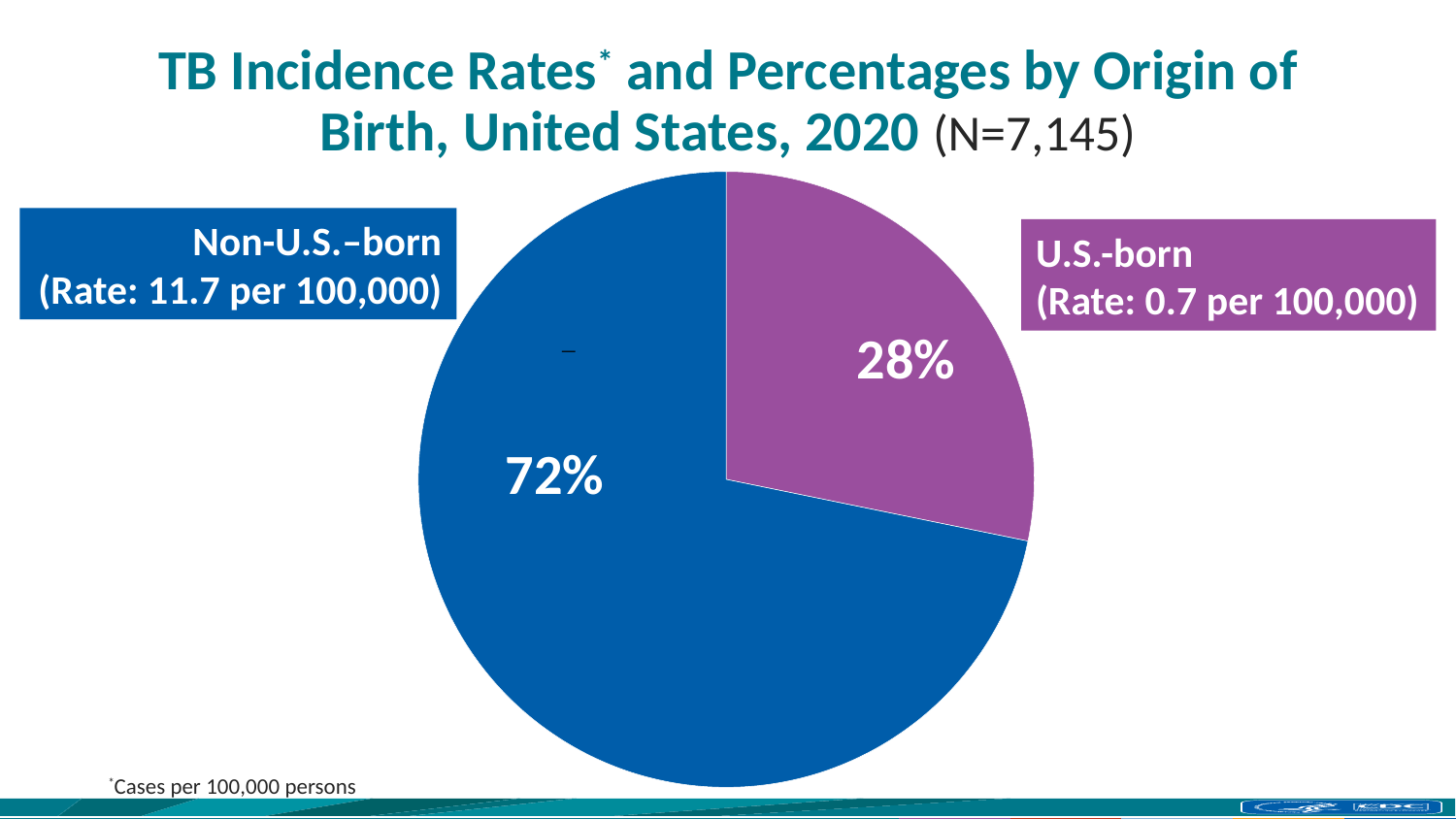
Which is larger: the share for U.S.-born or the share for Non-U.S.–born? Non-U.S.–born What percentage of TB cases is shown for U.S.-born persons? 28% What is the total number of cases (N) given in the chart title? 7,145 Which origin-of-birth group has the smaller share of the pie? U.S.-born Which origin-of-birth group has the larger share of the pie? Non-U.S.–born What kind of chart is shown on the slide? pie chart What percentage of TB cases is shown for Non-U.S.–born persons? 72% What is the TB incidence rate shown for U.S.-born persons? 0.7 per 100,000 What colour is the U.S.-born slice of the pie? purple What is the TB incidence rate shown for Non-U.S.–born persons? 11.7 per 100,000 What is the difference in percentage points between the Non-U.S.–born and U.S.-born slices? 44 How many slices does the pie chart have? 2